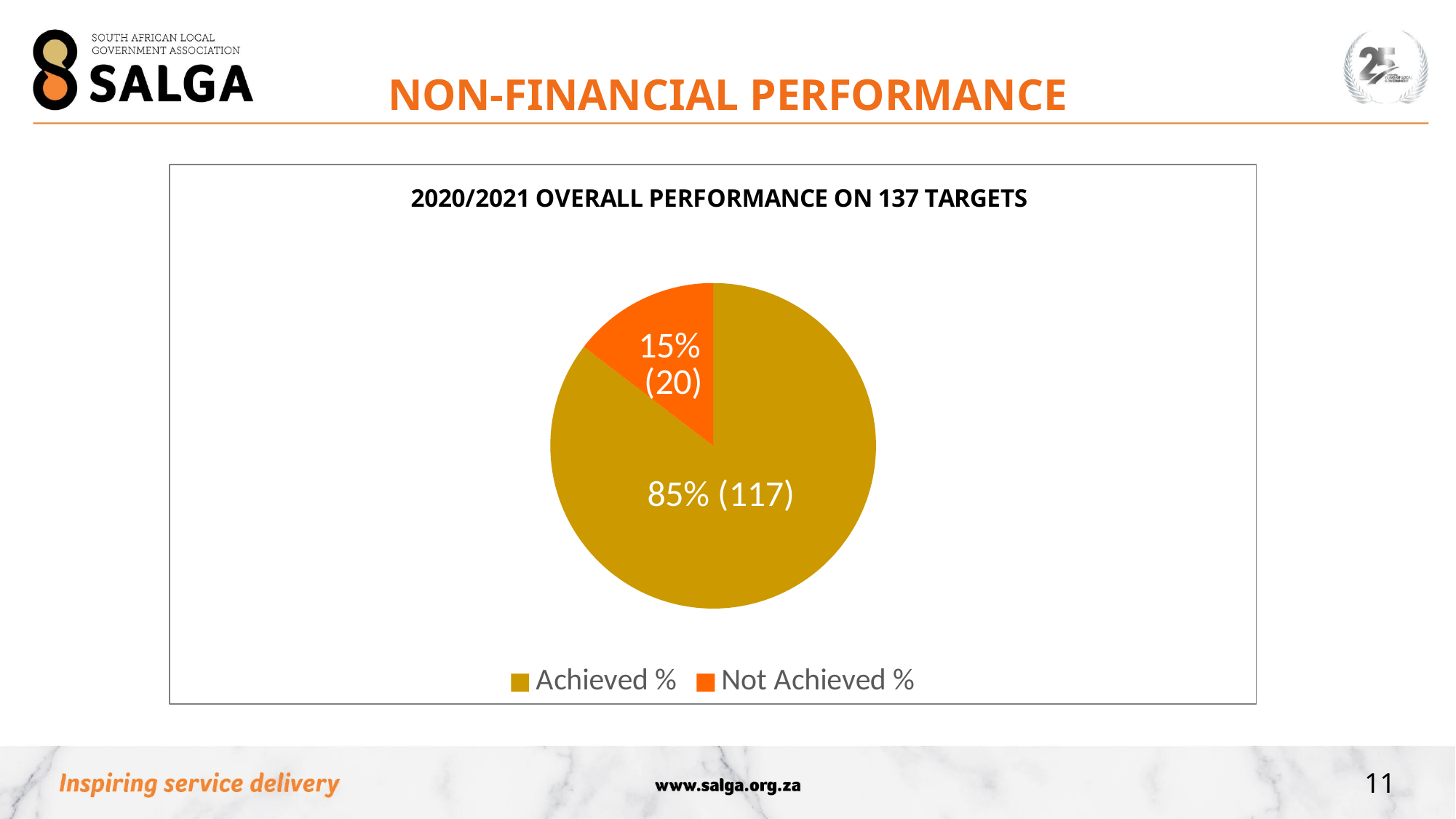
What kind of chart is shown on the slide? Pie chart Which slice of the pie is the largest? Achieved % Which slice of the pie is the smallest? Not Achieved % What percentage of targets were achieved? 85% How many targets were not achieved, according to the data label? 20 What is the title of the chart? 2020/2021 OVERALL PERFORMANCE ON 137 TARGETS How many slices does the pie chart have? 2 How many targets were achieved, according to the data label? 117 What colour is the Not Achieved % slice? Orange How many entries does the legend list? 2 What is the difference in percentage points between the Achieved and Not Achieved slices? 70 What percentage of targets were not achieved? 15%